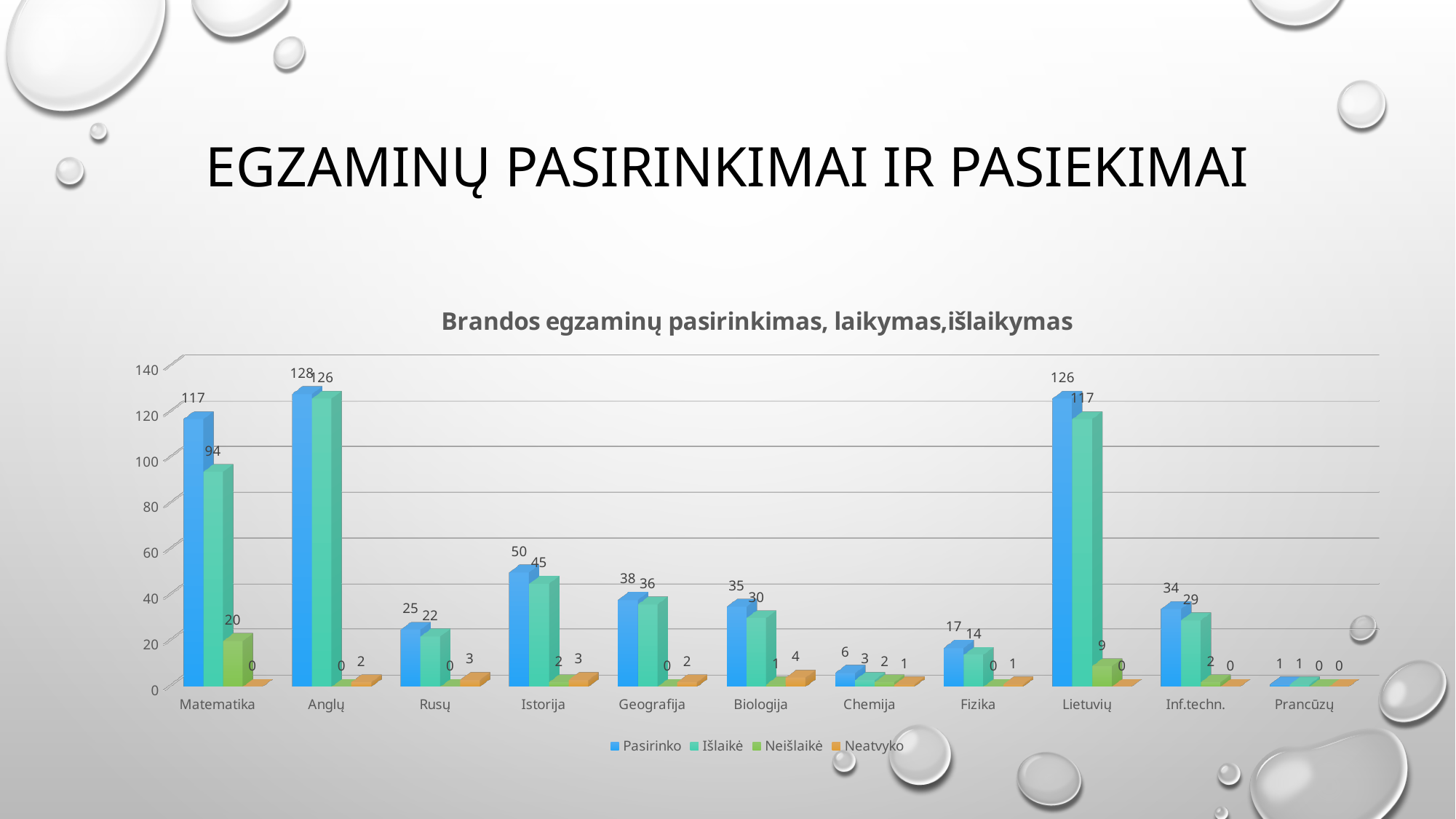
What is the Pasirinko value for Matematika? 117 What is the Neatvyko value for Biologija? 4 What kind of chart is shown on the slide? Bar chart What is the Išlaikė value for Lietuvių? 117 Which category has the highest Pasirinko value? Anglų What is the difference between the Pasirinko and Išlaikė values for Matematika? 23 What is the Neišlaikė value for Matematika? 20 Which is larger, the Išlaikė value for Anglų or the Išlaikė value for Lietuvių? Anglų How many categories are shown on the x axis? 11 Which category has the lowest Pasirinko value? Prancūzų What is the title of the chart? Brandos egzaminų pasirinkimas, laikymas,išlaikymas How many series does the legend list? 4